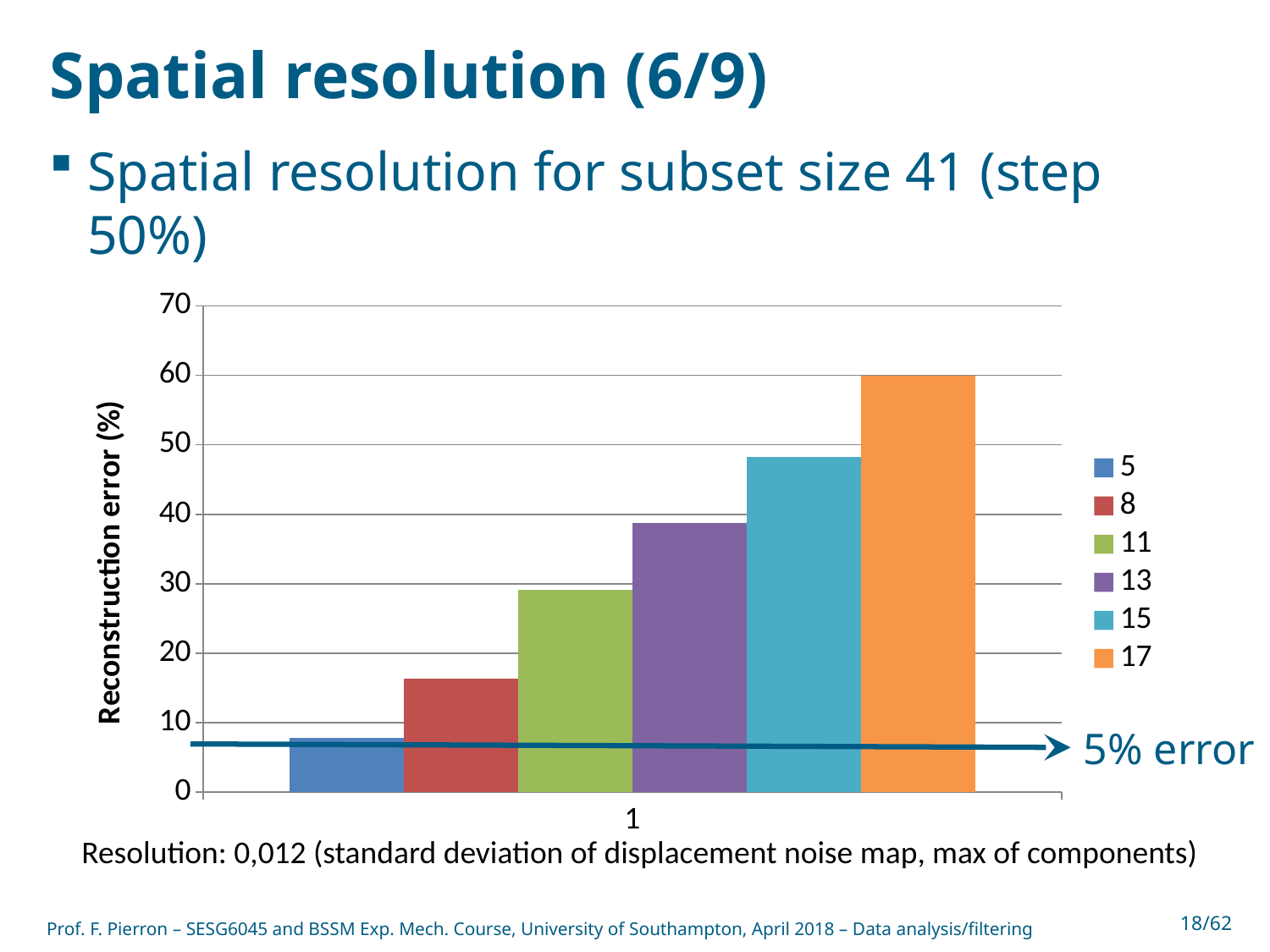
How many categories are shown on the x axis? 1 Is the reconstruction error for series 5 greater or less than 10? less Do the bars rise or fall going from series 5 to series 17? rise Is the reconstruction error for series 15 greater or less than 40? greater Which series has the larger reconstruction error, 13 or 11? 13 What is the title of the y axis? Reconstruction error (%) How many series does the legend list? 6 Is the reconstruction error for series 11 greater or less than 20? greater Which series has the highest reconstruction error? 17 Which series has the lowest reconstruction error? 5 What kind of chart is shown on the slide? bar chart